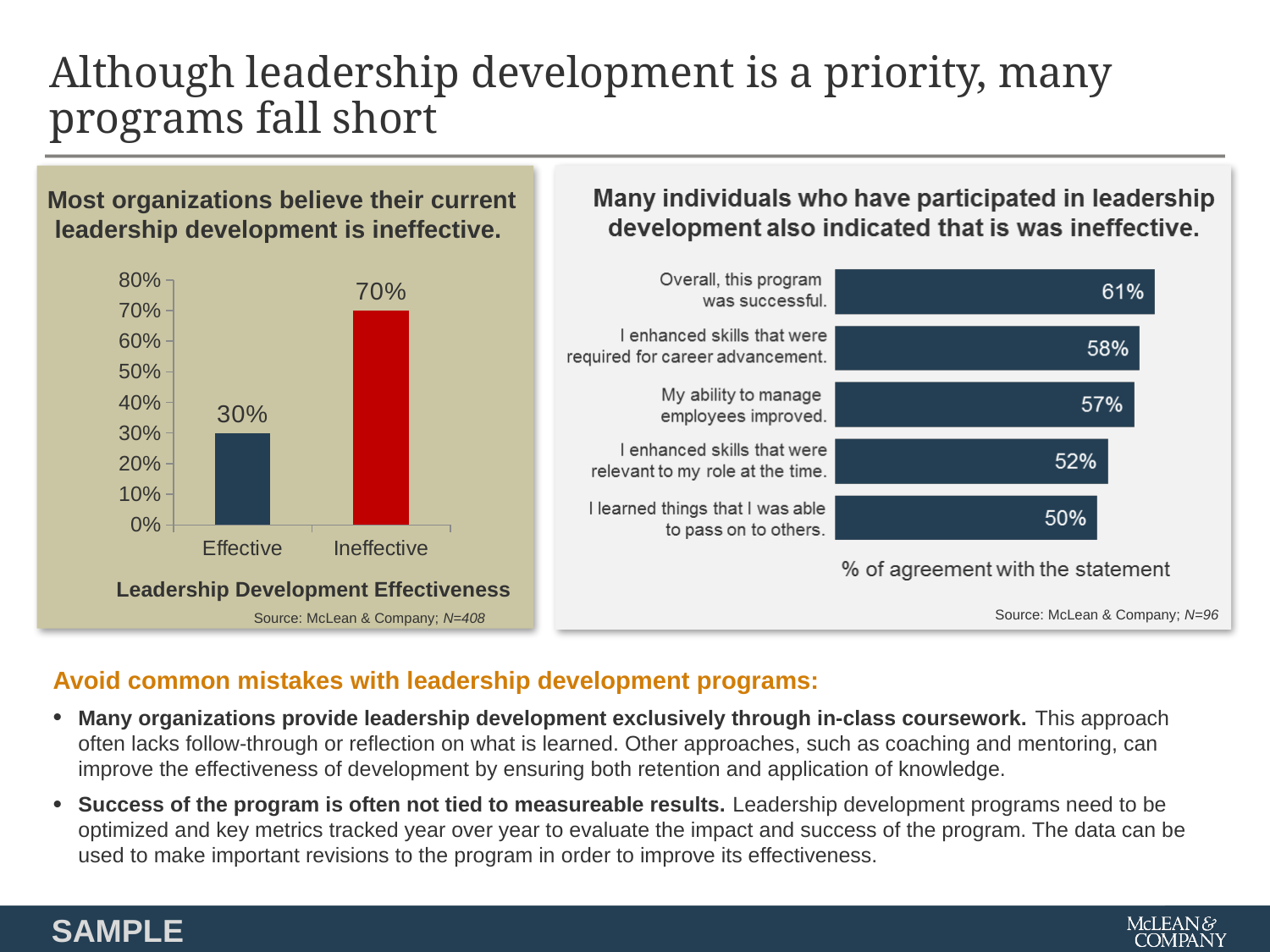
In the right chart, which statement has the lowest percentage of agreement? I learned things that I was able to pass on to others. In the left chart (Leadership Development Effectiveness), how many categories are plotted? 2 In the left chart (Leadership Development Effectiveness), which category has the higher value? Ineffective In the right chart, what percentage agreed with the statement 'Overall, this program was successful'? 61% In the right chart, how many statements are plotted? 5 In the left chart (Leadership Development Effectiveness), what percentage is shown for Effective? 30% In the left chart (Leadership Development Effectiveness), what is the difference between the Ineffective and Effective values? 40% In the right chart, what percentage agreed with 'I learned things that I was able to pass on to others'? 50% In the right chart, what does the axis label below the bars say? % of agreement with the statement What type of chart is the left chart (Leadership Development Effectiveness)? Bar chart In the right chart, what is the difference between 'I enhanced skills that were required for career advancement' and 'I enhanced skills that were relevant to my role at the time'? 6% In the left chart (Leadership Development Effectiveness), what percentage is shown for Ineffective? 70%